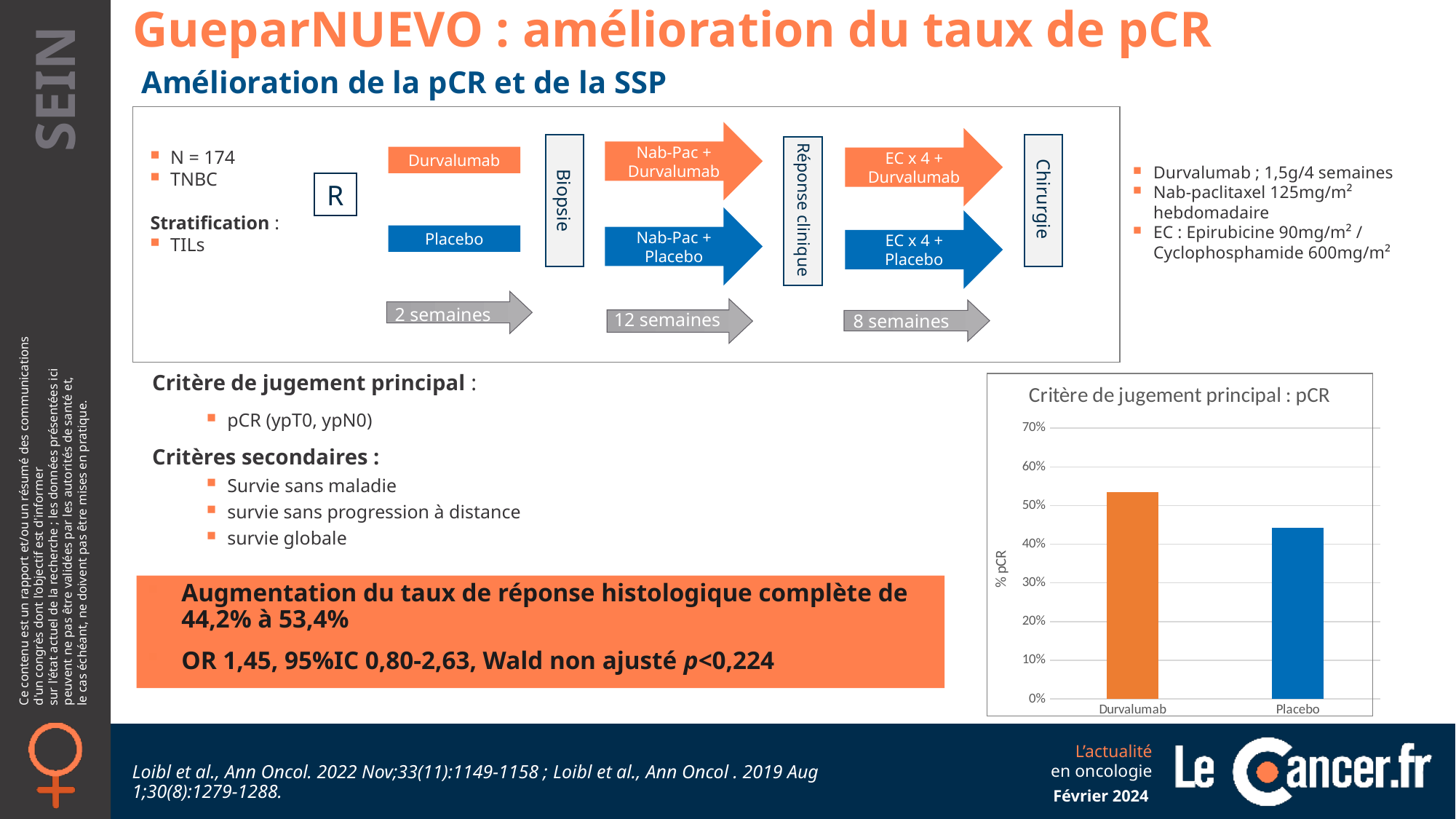
Which category has the lowest pCR rate in the chart? Placebo Which category has the highest pCR rate in the chart? Durvalumab Is the value for Durvalumab greater or less than 60%? less What is the label of the chart's vertical axis? % pCR How many categories are plotted in the chart? 2 Is the value for Durvalumab greater or less than 50%? greater Which bar is taller, Durvalumab or Placebo? Durvalumab What is the title of the chart? Critère de jugement principal : pCR Is the value for Placebo greater or less than 40%? greater Do the bar values rise or fall from Durvalumab to Placebo along the x axis? fall What kind of chart is shown on the slide? bar chart